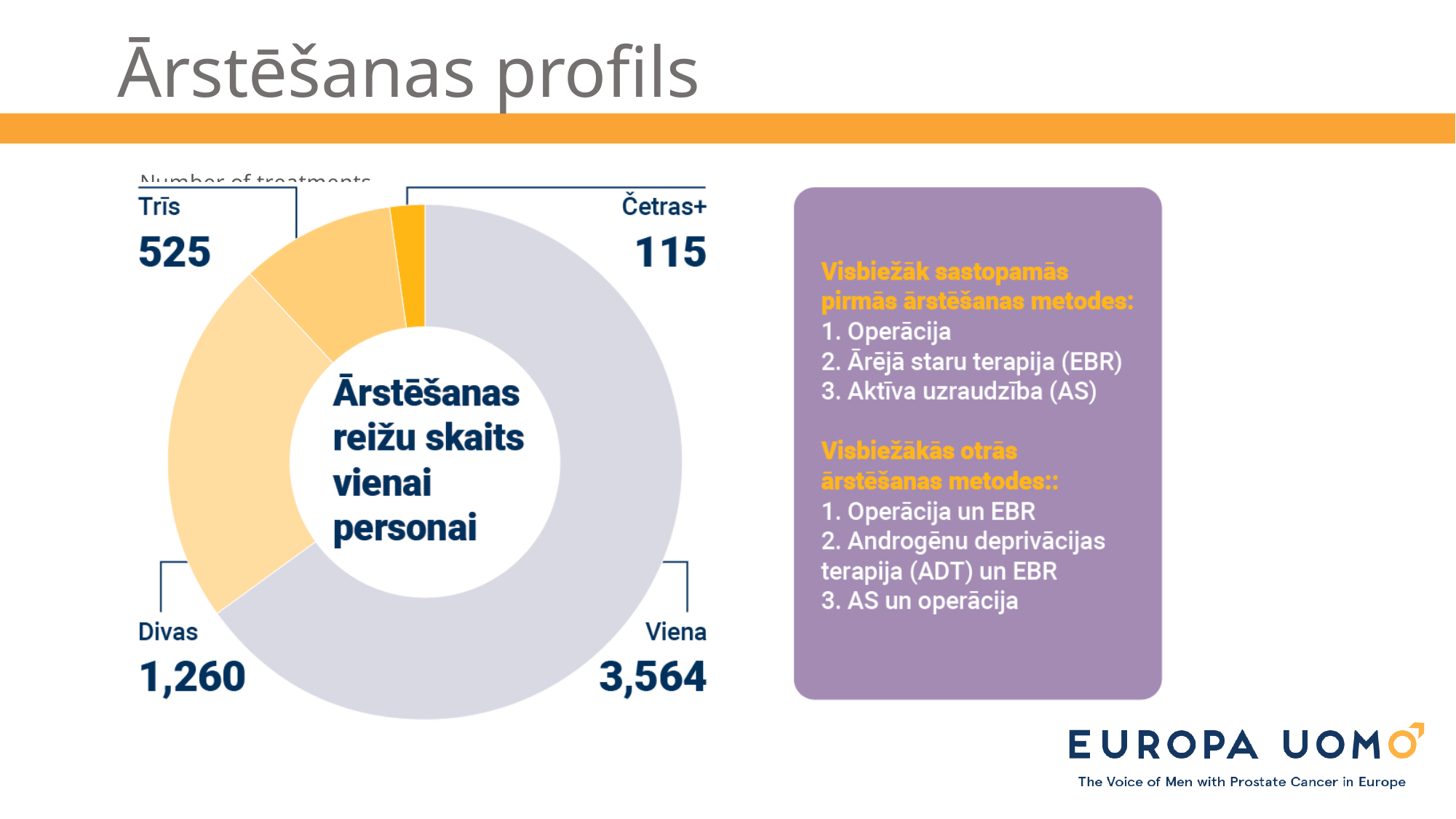
What is the difference between the values for "Trīs" and "Četras+" in the donut chart? 410 Which category in the donut chart has the lowest value? Četras+ What value is shown for the "Trīs" segment of the donut chart? 525 How many categories does the donut chart show? 4 What value is shown for the "Divas" segment of the donut chart? 1,260 What value is shown for the "Viena" segment of the donut chart? 3,564 Which is larger in the donut chart, the value for "Divas" or the value for "Trīs"? Divas What text is written in the centre of the donut chart? Ārstēšanas reižu skaits vienai personai What type of chart is shown on the slide? Donut (pie) chart What value is shown for the "Četras+" segment of the donut chart? 115 Which category in the donut chart has the highest value? Viena What is the difference between the values for "Viena" and "Divas" in the donut chart? 2,304